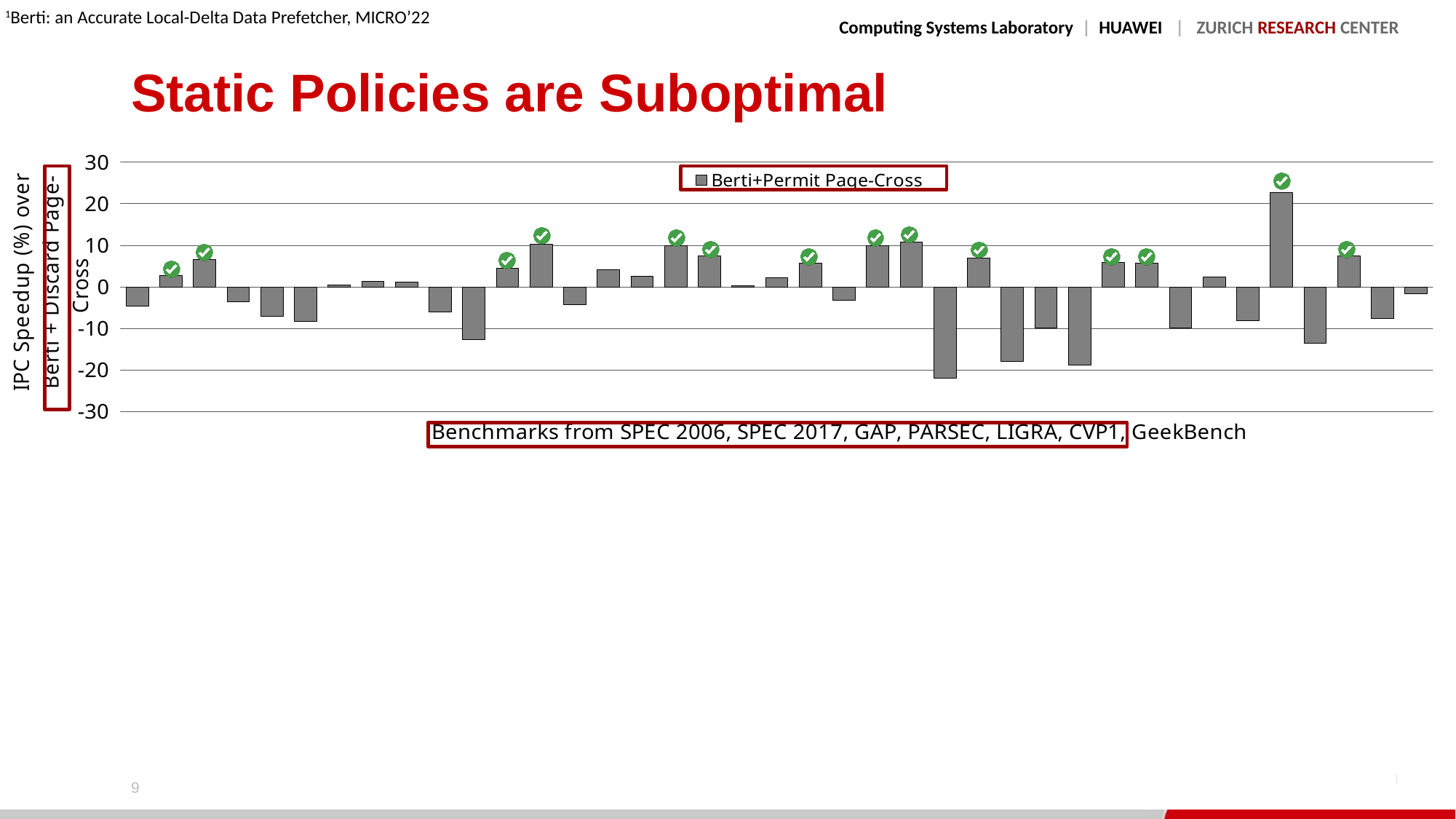
What is the highest tick value shown on the chart's vertical axis? 30 How many bars are plotted in the chart? 39 Is the value of the lowest bar in the chart greater or less than -30? greater What is the label of the chart's vertical axis? IPC Speedup (%) over Berti + Discard Page-Cross Is the value of the lowest bar in the chart greater or less than -20? less Is the value of the tallest bar in the chart greater or less than 30? less What kind of chart is shown on the slide? bar chart What is the name of the series shown in the chart legend? Berti+Permit Page-Cross How many series does the chart legend list? 1